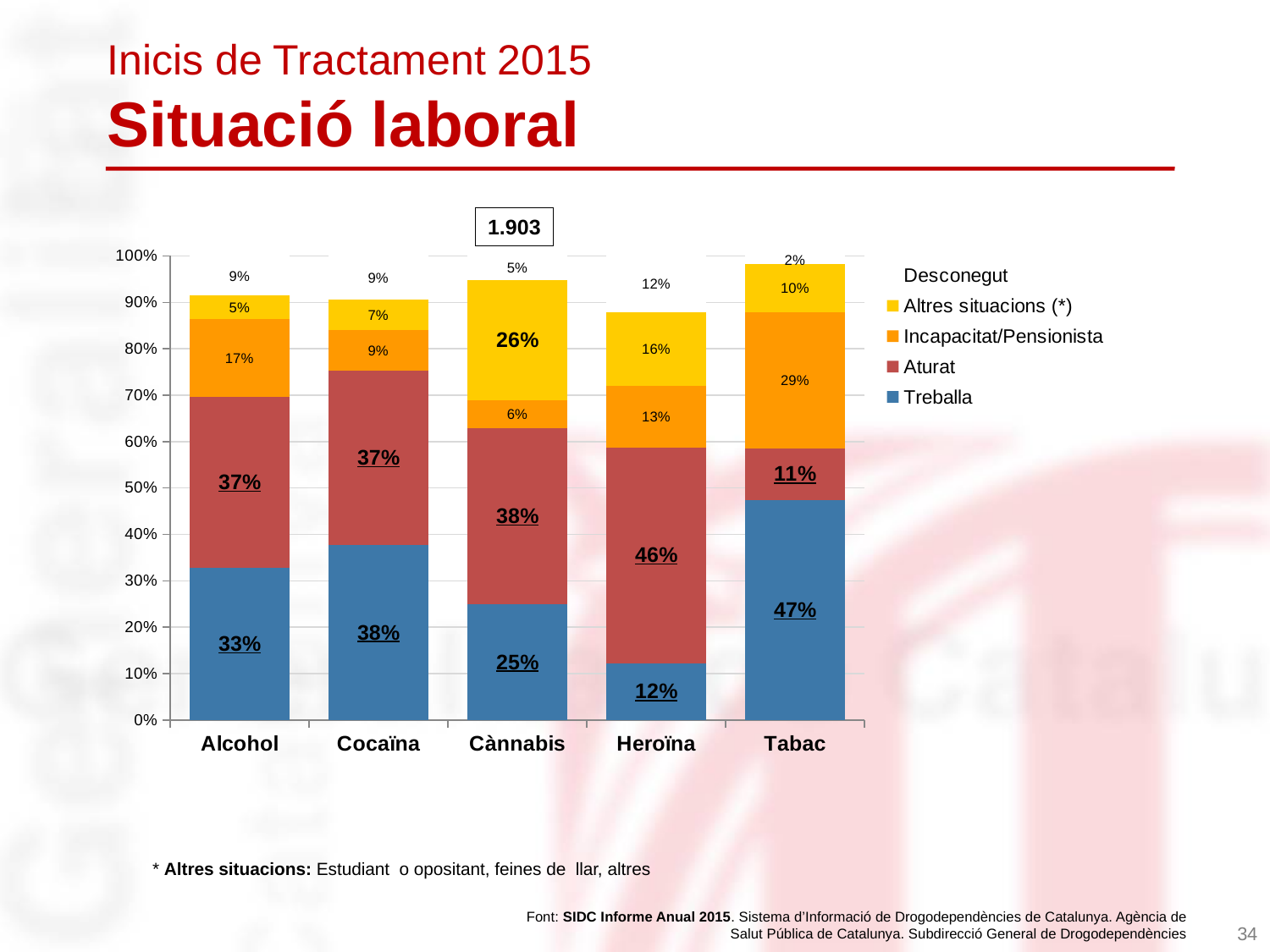
What is the Incapacitat/Pensionista percentage for Alcohol? 17% What is the Treballa percentage for Tabac? 47% Which is larger, the Treballa percentage for Cocaïna or for Cànnabis? Cocaïna What is the Aturat percentage for Heroïna? 46% How many categories are shown on the x axis? 5 Which category has the highest Treballa percentage? Tabac What kind of chart is shown on the slide? Stacked bar chart How many series does the legend list? 5 What number is shown in the box above the chart? 1.903 What is the difference between the Aturat percentage for Heroïna and for Tabac? 35% What is the Altres situacions (*) percentage for Cànnabis? 26% Which category has the lowest Treballa percentage? Heroïna